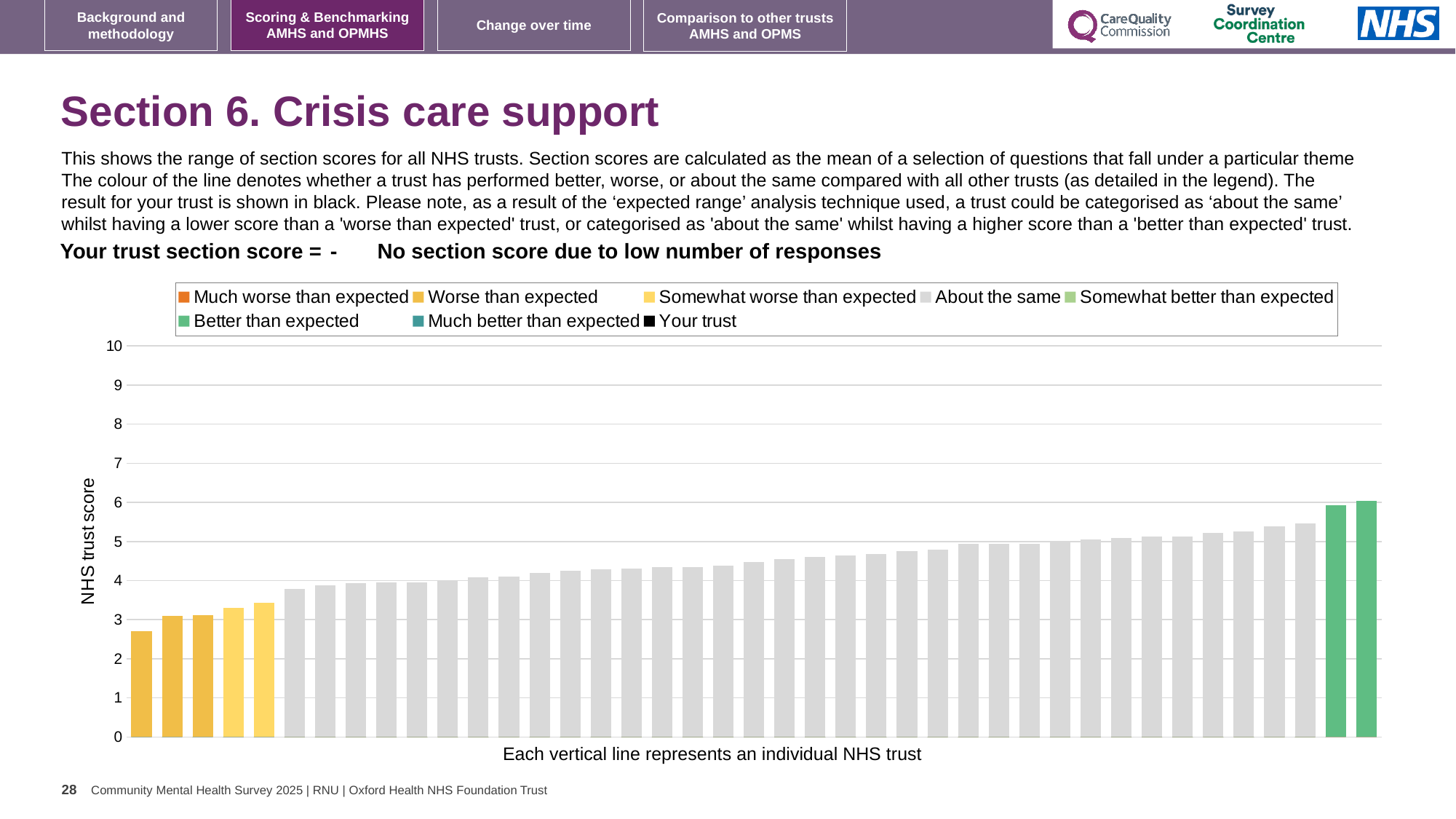
How many bars are coloured in the 'Worse than expected' colour? 3 How many entries does the chart legend list? 8 Do the bar values rise or fall moving from left to right along the x axis? rise What kind of chart is shown on the slide? bar chart Which legend category does the highest bar belong to? Better than expected What is the label on the vertical axis of the chart? NHS trust score Is the value of the rightmost (highest) bar greater or less than 5? greater How many bars are coloured green (Better than expected)? 2 Is the value of the leftmost (lowest) bar greater or less than 3? less Which is larger, the leftmost bar or the rightmost bar? the rightmost bar Is the value of the tallest bar greater or less than 7? less Which legend category does the lowest bar belong to? Worse than expected